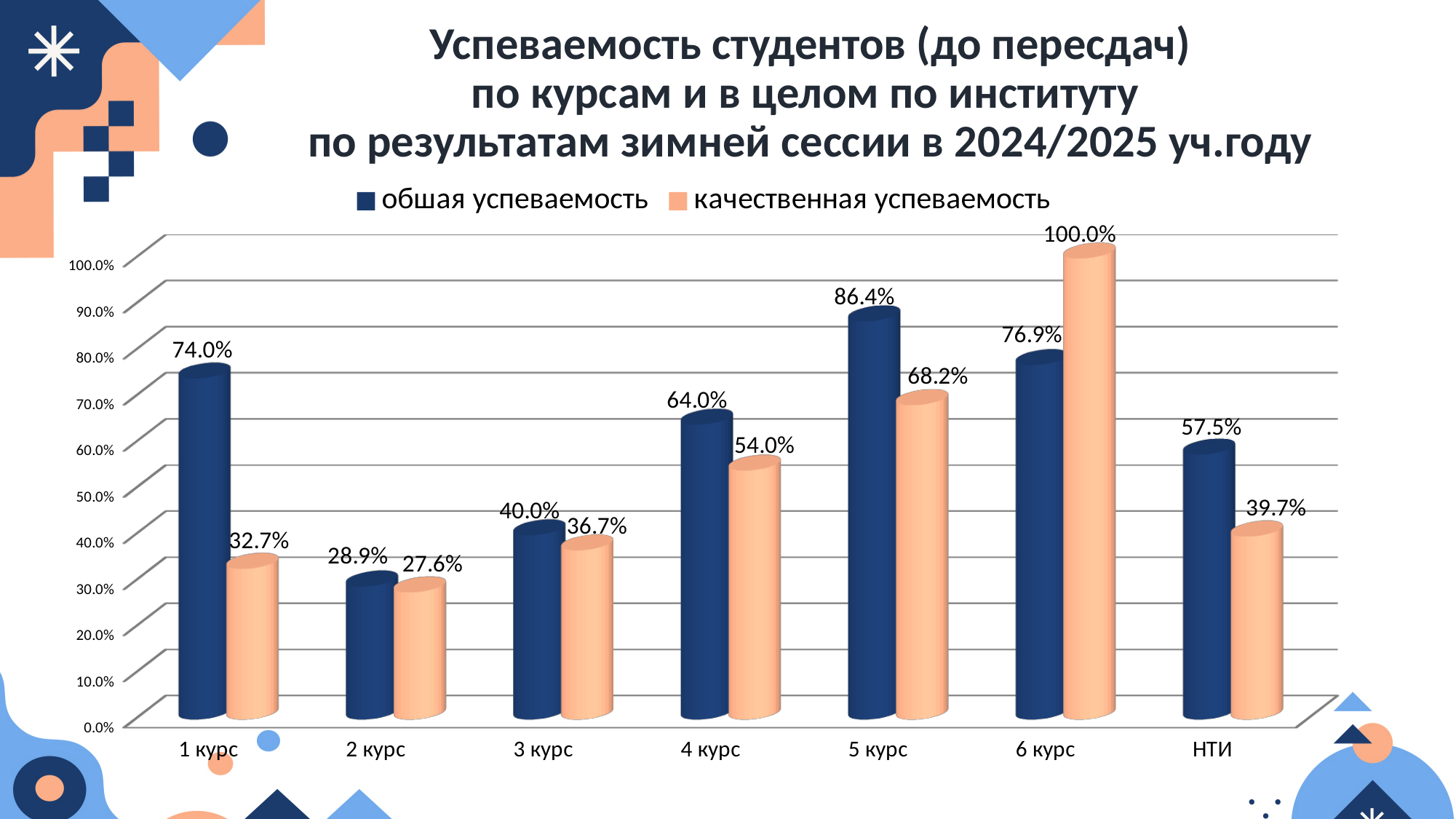
What is the value of качественная успеваемость for 4 курс? 54.0% What is the difference between обшая успеваемость and качественная успеваемость for 1 курс? 41.3% Which colour represents качественная успеваемость in the chart? orange Which category has the highest value of качественная успеваемость? 6 курс What is the value of обшая успеваемость for НТИ? 57.5% Which is larger for 6 курс: обшая успеваемость or качественная успеваемость? качественная успеваемость What is the value of обшая успеваемость for 5 курс? 86.4% What kind of chart is shown on the slide? bar chart How many categories are shown on the x axis? 7 What is the value of качественная успеваемость for 1 курс? 32.7% How many series does the legend list? 2 Which category has the lowest value of обшая успеваемость? 2 курс